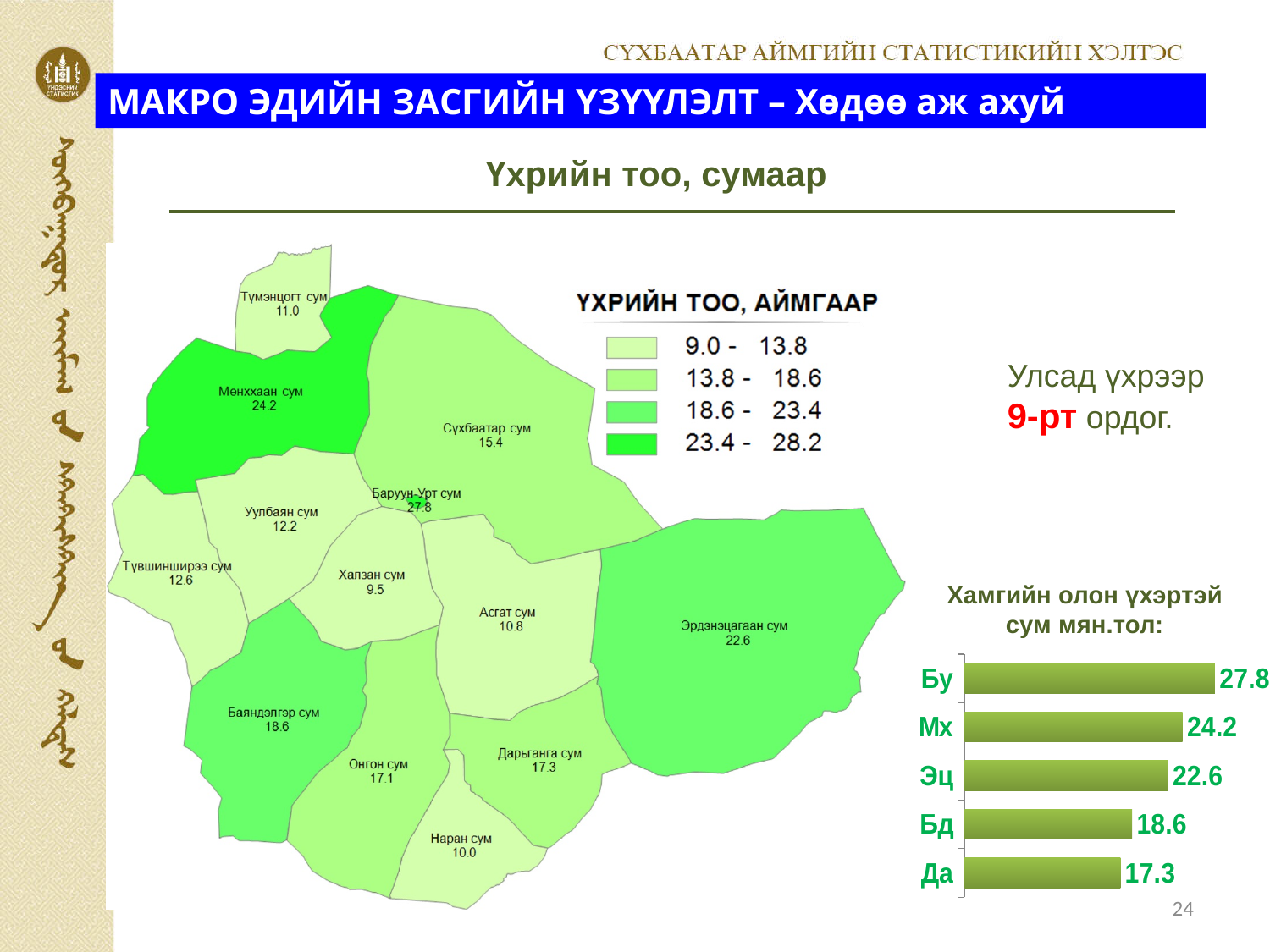
In the bar chart titled 'Хамгийн олон үхэртэй сум мян.тол:', what is the value for Бу? 27.8 In the bar chart titled 'Хамгийн олон үхэртэй сум мян.тол:', which category has the lowest value? Да In the bar chart titled 'Хамгийн олон үхэртэй сум мян.тол:', which is larger, the value for Мх or the value for Эц? Мх In the bar chart titled 'Хамгийн олон үхэртэй сум мян.тол:', which category has the highest value? Бу On the map titled 'ҮХРИЙН ТОО, АЙМГААР', how many value ranges does the legend list? 4 How many categories are shown in the bar chart titled 'Хамгийн олон үхэртэй сум мян.тол:'? 5 In the bar chart titled 'Хамгийн олон үхэртэй сум мян.тол:', what is the difference between the values for Бу and Мх? 3.6 What kind of chart is the one titled 'Хамгийн олон үхэртэй сум мян.тол:'? bar chart In the bar chart titled 'Хамгийн олон үхэртэй сум мян.тол:', what is the difference between the values for Бд and Да? 1.3 In the bar chart titled 'Хамгийн олон үхэртэй сум мян.тол:', what is the value for Эц? 22.6 In the bar chart titled 'Хамгийн олон үхэртэй сум мян.тол:', what is the value for Да? 17.3 On the map titled 'ҮХРИЙН ТОО, АЙМГААР', what value is shown for Мөнххаан сум? 24.2